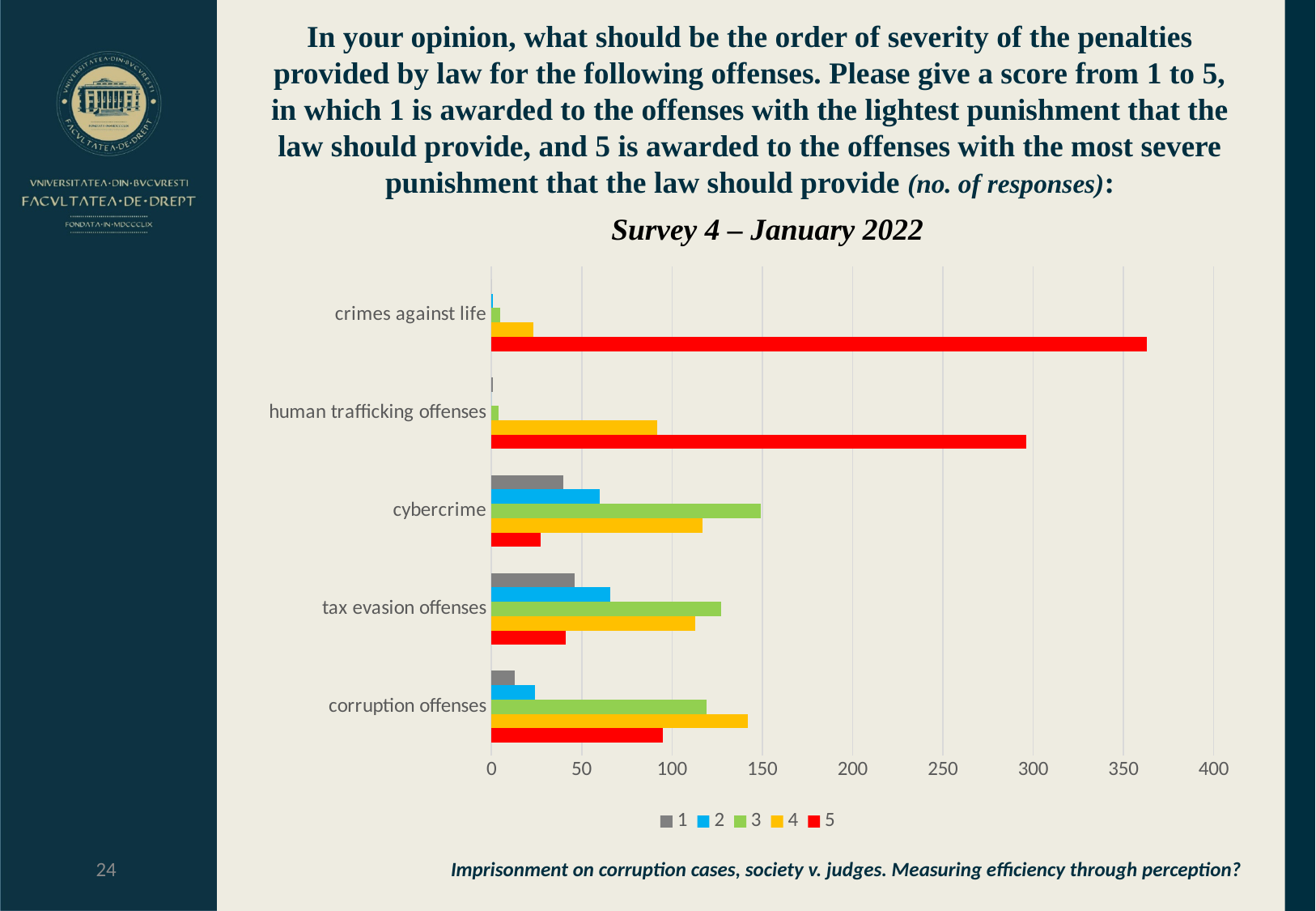
Which offense category has the lowest value for score 5? cybercrime Which offense category has the highest value for score 5? crimes against life For cybercrime, which is larger: the value for score 3 or the value for score 4? score 3 How many series does the legend list? 5 How many offense categories are plotted on the chart? 5 What are the entries listed in the chart legend? 1, 2, 3, 4, 5 What kind of chart is shown on the slide? bar chart Is the value for score 5 for crimes against life greater or less than 350? greater For corruption offenses, which is larger: the value for score 3 or the value for score 4? score 4 Is the value for score 3 for cybercrime greater or less than 100? greater Is the value for score 5 for human trafficking offenses greater or less than 250? greater